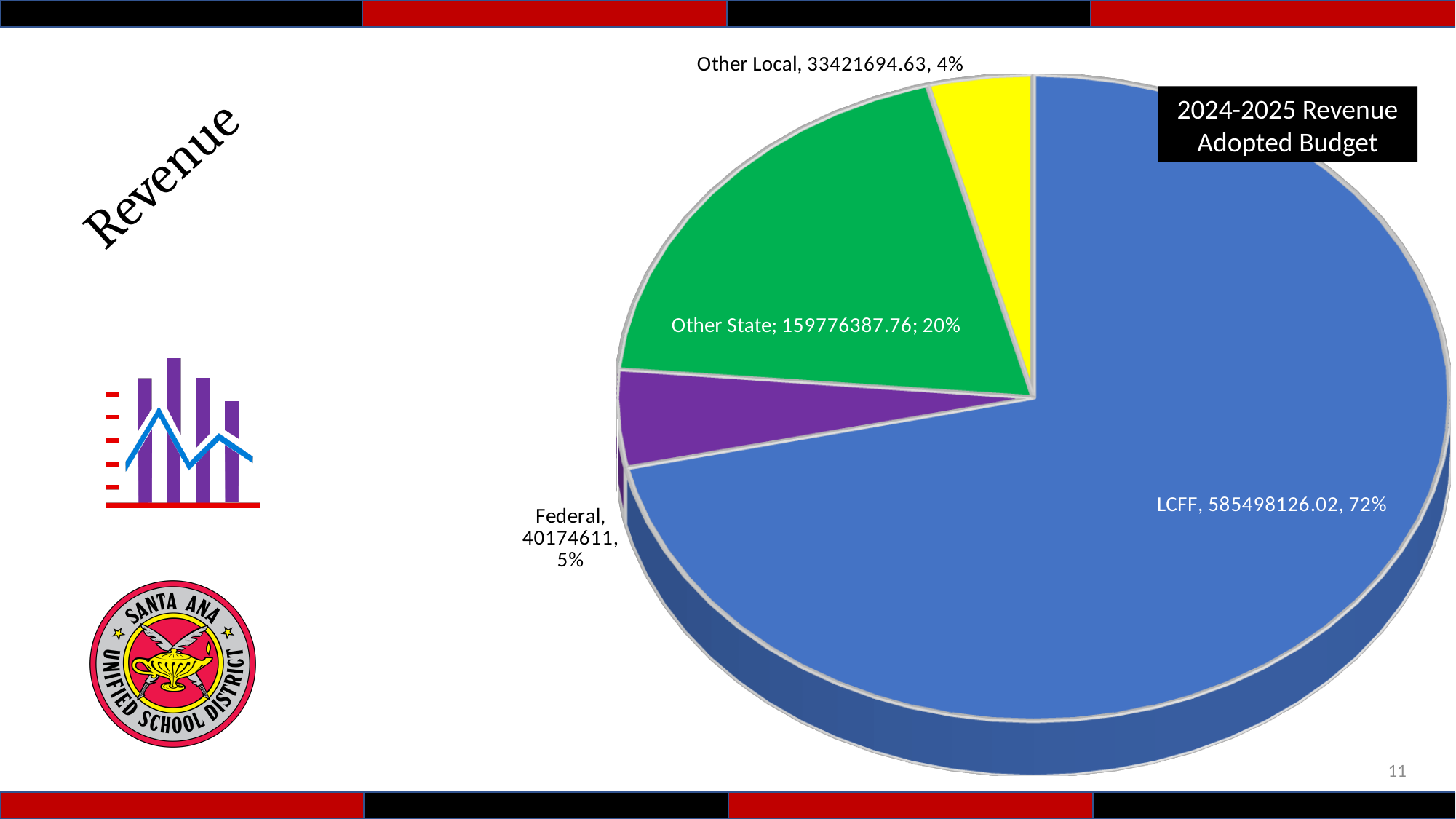
What is the difference between the LCFF value and the Other State value? 425721738.26 What is the value for Other Local in the pie chart? 33421694.63 What type of chart is shown on the slide? Pie chart What is the value for LCFF in the pie chart? 585498126.02 What is the title of the pie chart? 2024-2025 Revenue Adopted Budget What share of the pie does Other State represent? 20% What is the value for Other State in the pie chart? 159776387.76 Which category has the largest share of the pie chart? LCFF How many slices does the pie chart have? 4 What is the value for Federal in the pie chart? 40174611 Which is larger, the Federal value or the Other Local value? Federal Which category has the smallest share of the pie chart? Other Local